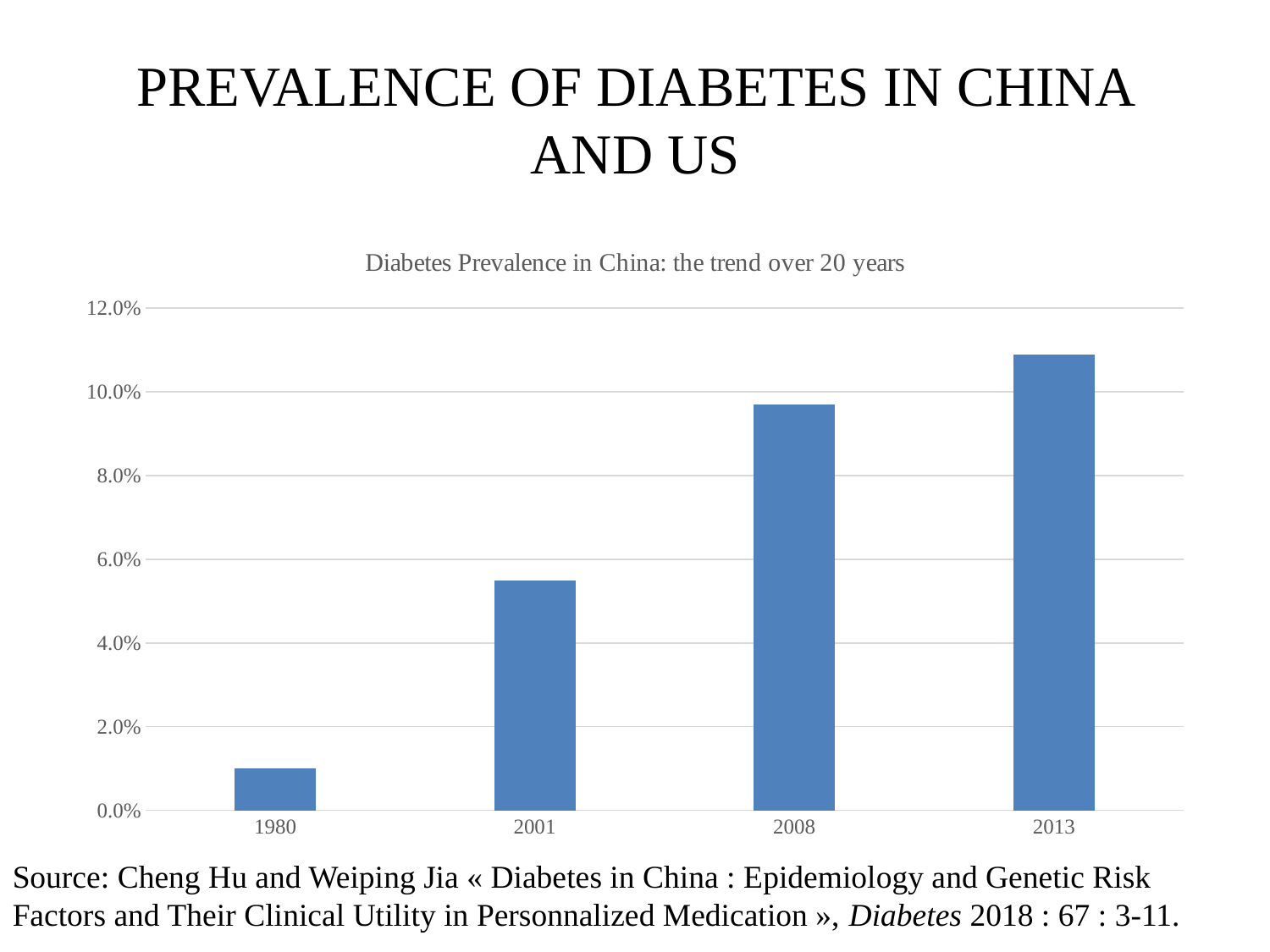
What is the title of the chart? Diabetes Prevalence in China: the trend over 20 years How many years are shown on the x axis of the chart? 4 Is the value for 2013 greater or less than 10.0%? greater What kind of chart is shown on the slide? bar chart What is the highest value shown on the y axis of the chart? 12.0% Which year has the highest diabetes prevalence in the chart? 2013 Is the value for 2001 greater or less than 4.0%? greater Is the value for 1980 greater or less than 2.0%? less Do the values rise or fall from 1980 to 2013 along the x axis? rise Which year has the lowest diabetes prevalence in the chart? 1980 Which is larger, the value for 2001 or the value for 2008? 2008